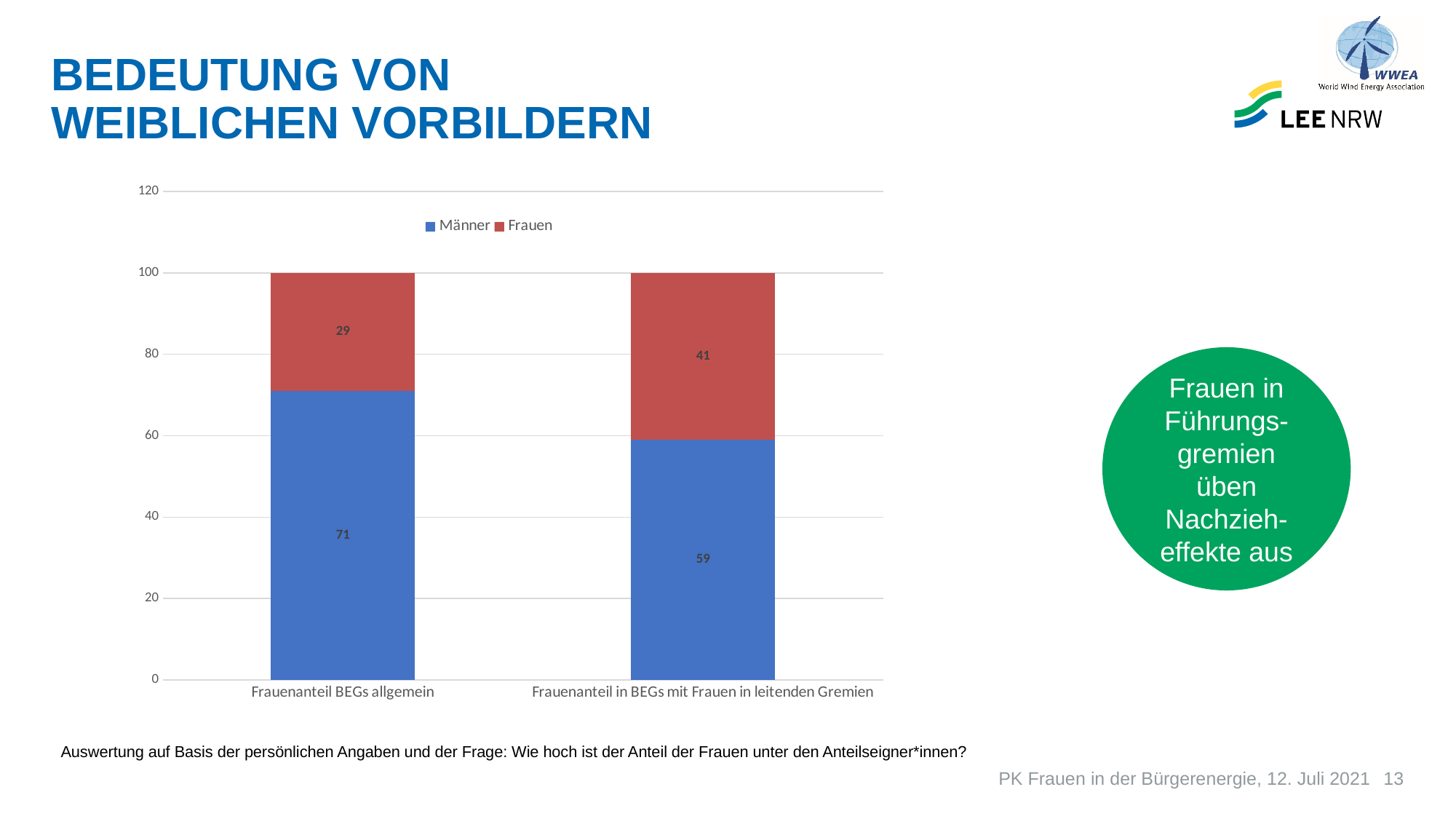
What is the total of the stacked bar for 'Frauenanteil BEGs allgemein'? 100 What is the value for Frauen in the 'Frauenanteil BEGs allgemein' bar? 29 Is the Männer value larger for 'Frauenanteil BEGs allgemein' or for 'Frauenanteil in BEGs mit Frauen in leitenden Gremien'? Frauenanteil BEGs allgemein What is the value for Männer in the 'Frauenanteil BEGs allgemein' bar? 71 Which category has the higher Frauen value? Frauenanteil in BEGs mit Frauen in leitenden Gremien What is the value for Frauen in the 'Frauenanteil in BEGs mit Frauen in leitenden Gremien' bar? 41 What kind of chart is shown on the slide? Stacked bar chart What is the difference between the Frauen values of the two categories? 12 What is the value for Männer in the 'Frauenanteil in BEGs mit Frauen in leitenden Gremien' bar? 59 Which category has the lower Männer value? Frauenanteil in BEGs mit Frauen in leitenden Gremien How many categories are shown on the x axis? 2 How many series does the legend list? 2